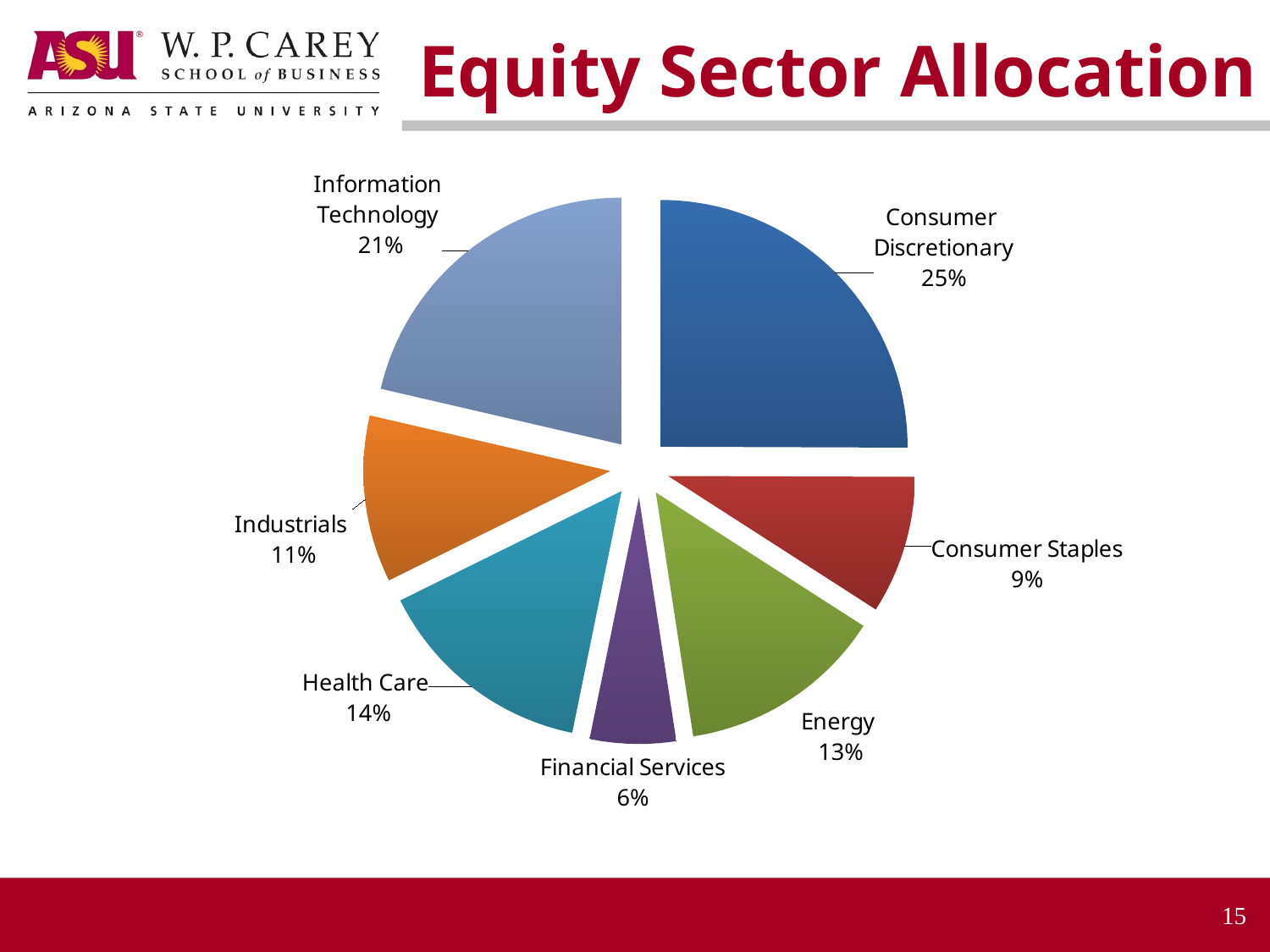
What share of the equity allocation is Information Technology? 21% Which sector has the smallest share of the equity allocation? Financial Services What is the title of the slide containing the pie chart? Equity Sector Allocation How many sectors are shown in the pie chart? 7 Which sector has a larger share, Industrials or Health Care? Health Care What share of the equity allocation is Consumer Discretionary? 25% What is the combined share of Consumer Staples and Energy? 22% What kind of chart is shown on the slide? Pie chart What is the difference in percentage points between Consumer Discretionary and Energy? 12 What share of the equity allocation is Health Care? 14% What share of the equity allocation is Financial Services? 6% Which sector has the largest share of the equity allocation? Consumer Discretionary